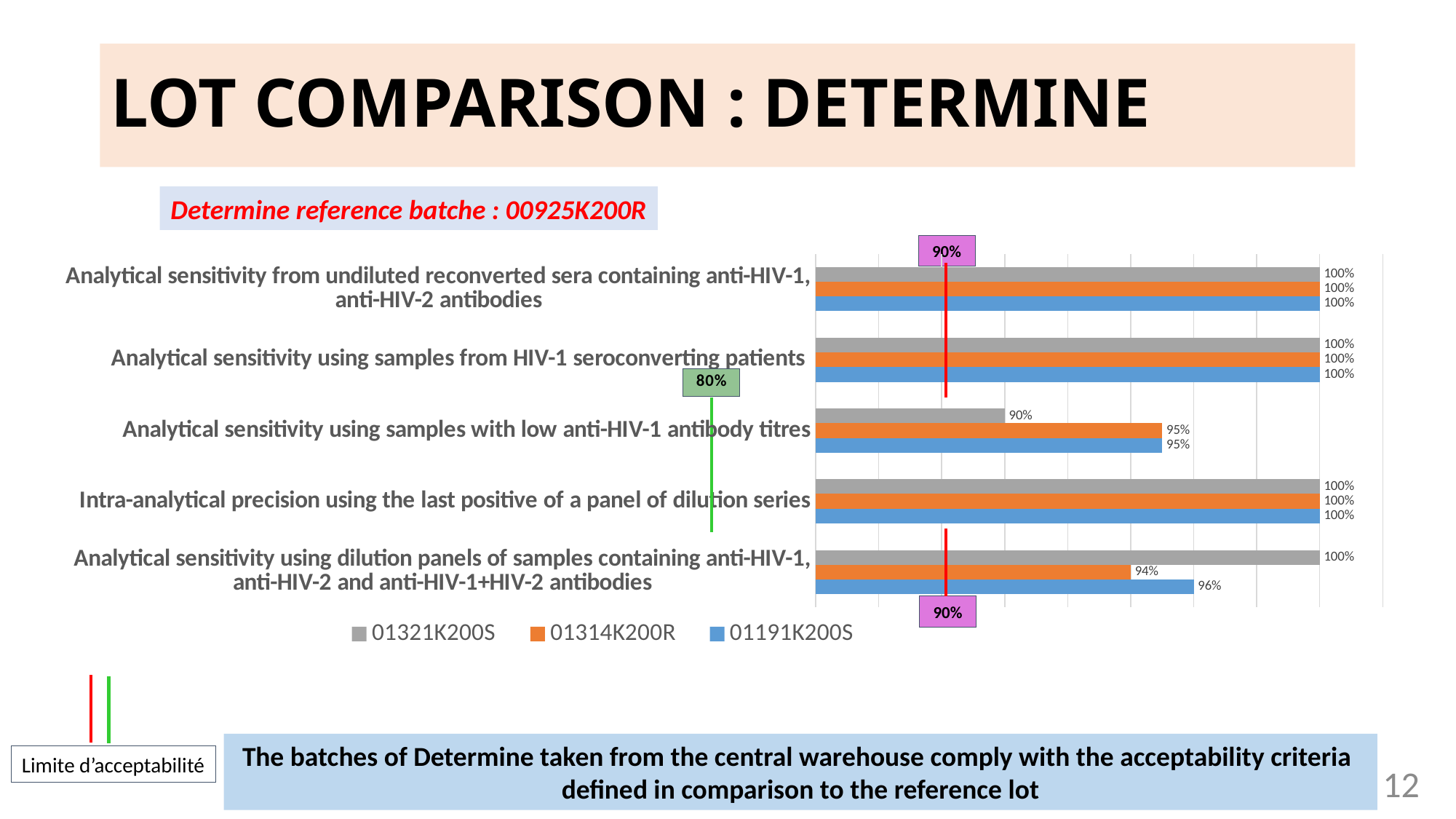
What is the value for 01321K200S in the category 'Analytical sensitivity using samples with low anti-HIV-1 antibody titres'? 90% What is the difference between the 01314K200R and 01321K200S values in the category 'Analytical sensitivity using samples with low anti-HIV-1 antibody titres'? 5% Which series has the lowest value in the category 'Analytical sensitivity using samples with low anti-HIV-1 antibody titres'? 01321K200S How many categories are plotted on the chart? 5 What is the value for 01314K200R in the category 'Analytical sensitivity using dilution panels of samples containing anti-HIV-1, anti-HIV-2 and anti-HIV-1+HIV-2 antibodies'? 94% How many series does the chart legend list? 3 Which series has the highest value in the category 'Analytical sensitivity using dilution panels of samples containing anti-HIV-1, anti-HIV-2 and anti-HIV-1+HIV-2 antibodies'? 01321K200S What kind of chart is shown on the slide? bar chart In the category 'Analytical sensitivity using dilution panels of samples containing anti-HIV-1, anti-HIV-2 and anti-HIV-1+HIV-2 antibodies', which is larger: the value for 01314K200R or for 01191K200S? 01191K200S Which series is shown in orange in the chart legend? 01314K200R What is the value for 01191K200S in the category 'Analytical sensitivity using dilution panels of samples containing anti-HIV-1, anti-HIV-2 and anti-HIV-1+HIV-2 antibodies'? 96% What is the value for 01191K200S in the category 'Analytical sensitivity using samples with low anti-HIV-1 antibody titres'? 95%